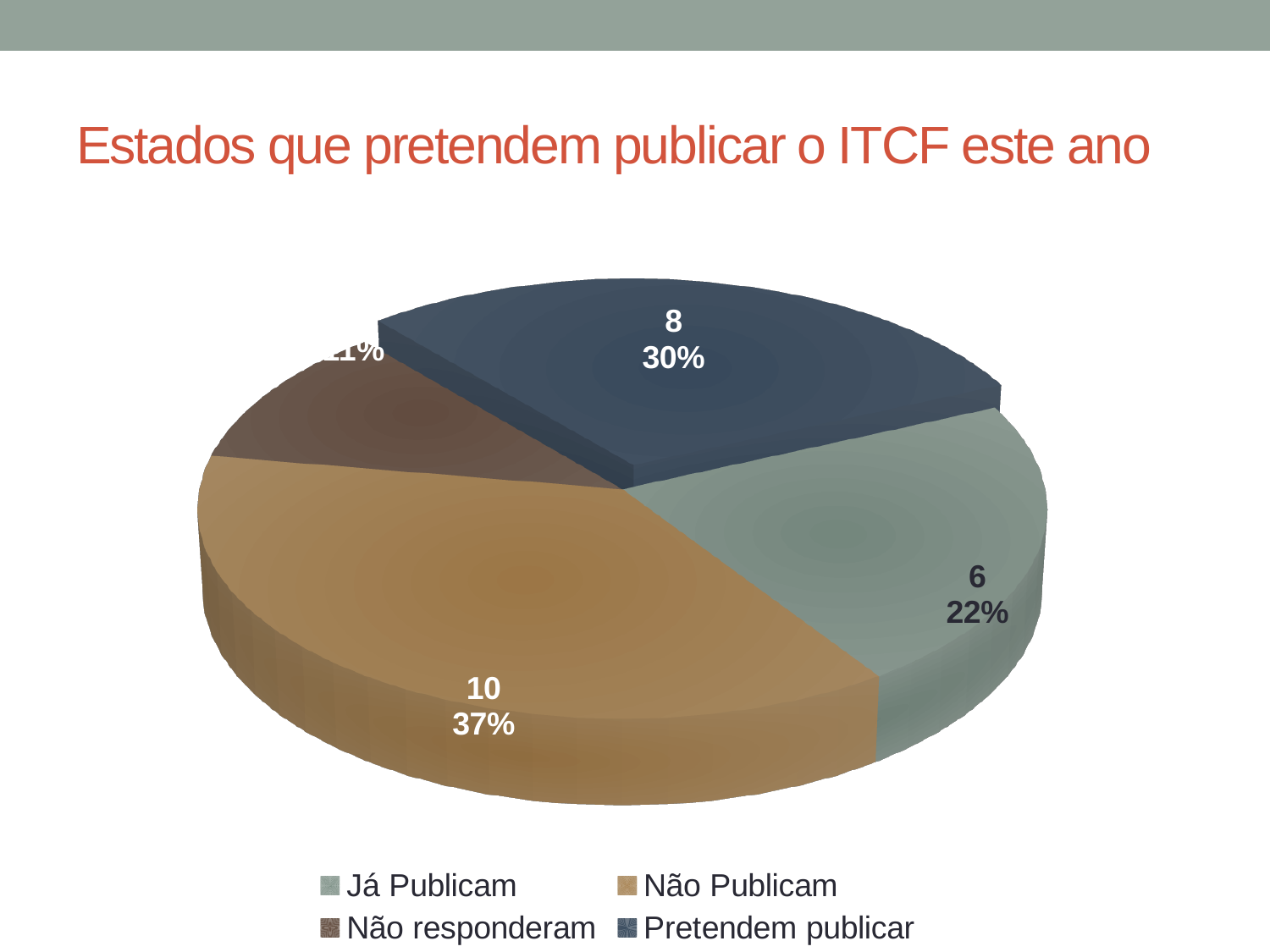
What share of the pie does Não Publicam represent? 37% What kind of chart is shown on the slide? pie chart What share of the pie does Já Publicam represent? 22% What share of the pie does Pretendem publicar represent? 30% Which category has the smallest slice of the pie? Não responderam Which is larger, the value for Pretendem publicar or the value for Já Publicam? Pretendem publicar How many categories does the legend list? 4 What is the title of the chart? Estados que pretendem publicar o ITCF este ano Which category has the largest slice of the pie? Não Publicam What is the value shown for Pretendem publicar? 8 What is the value shown for Não Publicam? 10 What is the value shown for Já Publicam? 6